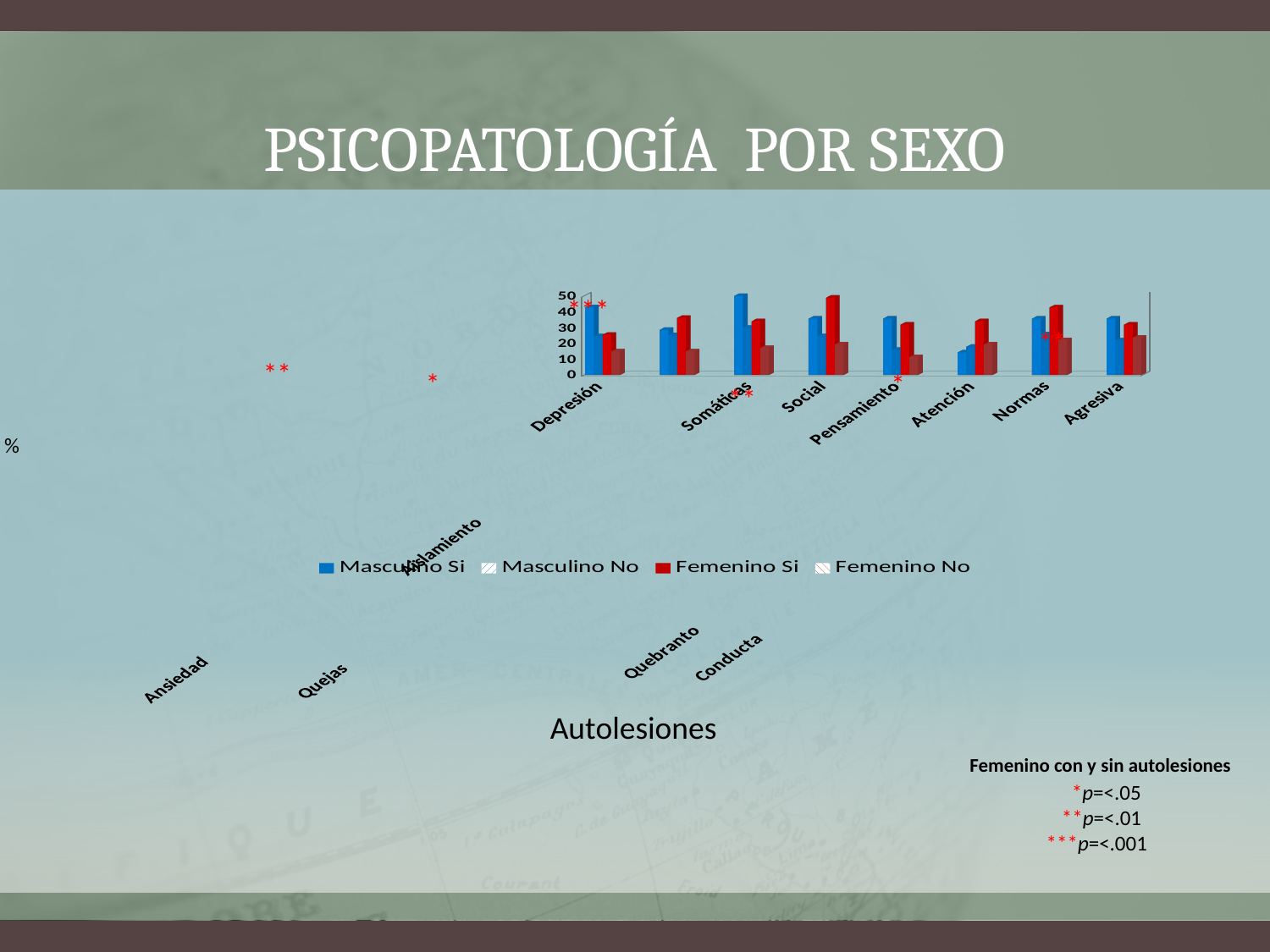
How many series does the chart legend list? 4 Is the Femenino Si value for Social greater or less than 40? greater How many categories are shown on the x axis of the chart? 8 What kind of chart is shown on the slide? bar chart Is the Masculino Si value for Somáticas greater or less than 40? greater For Social, which is larger: the Femenino Si value or the Masculino Si value? Femenino Si Which category has the lowest Masculino Si value? Atención For Atención, which is larger: the Masculino Si value or the Femenino Si value? Femenino Si Is the Masculino Si value for Atención greater or less than 20? less Which series are listed in the chart legend? Masculino Si, Masculino No, Femenino Si, Femenino No What is the title of the slide containing the chart? PSICOPATOLOGÍA POR SEXO